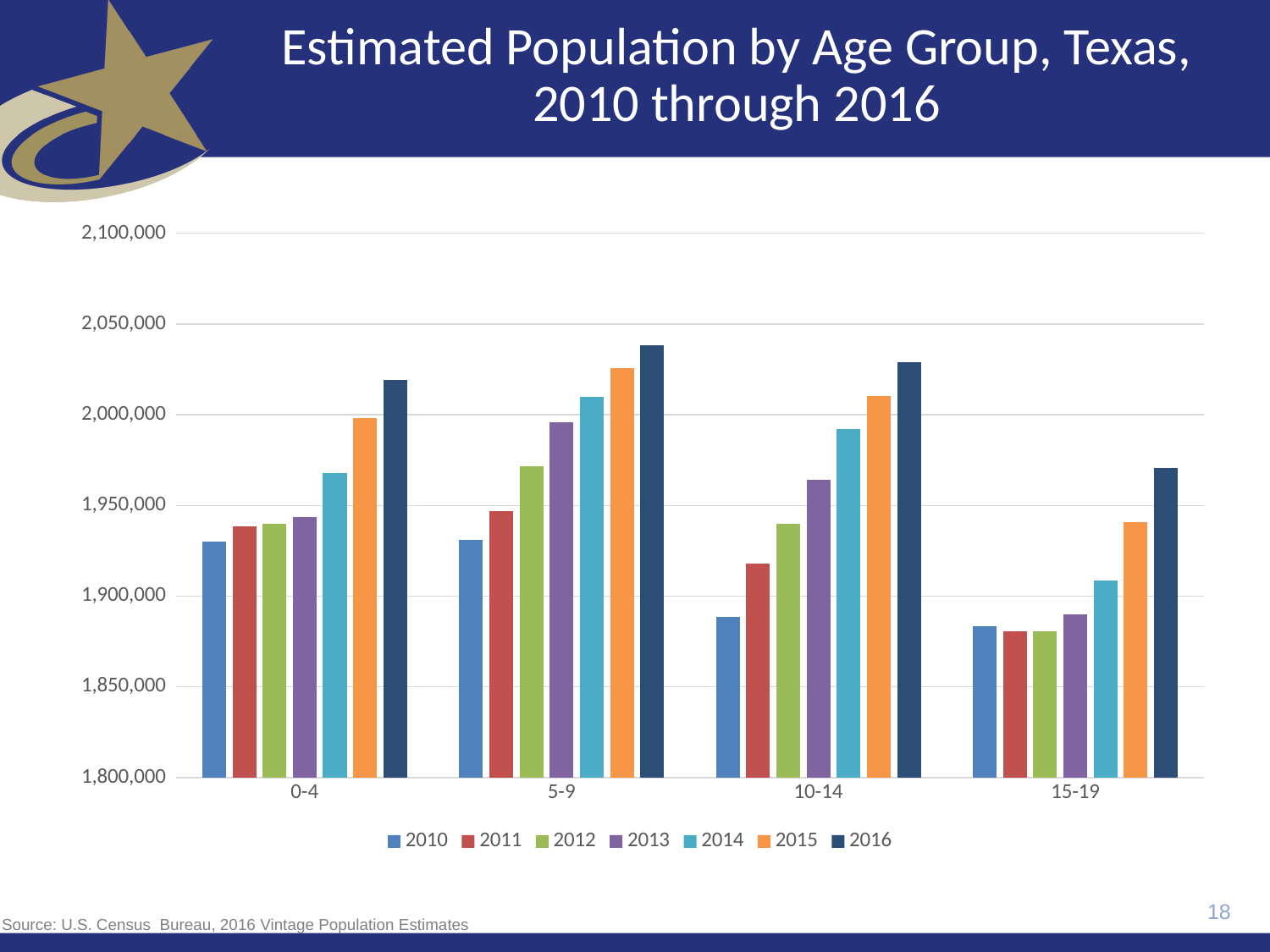
Which is larger: the 2015 value for 10-14 or the 2015 value for 15-19? 10-14 How many series (years) does the legend list? 7 Which age group has the lowest 2016 value? 15-19 What is the source cited for the chart data? U.S. Census Bureau, 2016 Vintage Population Estimates For the 5-9 age group, do the values rise or fall from 2010 to 2016? rise What kind of chart is shown on the slide? Bar chart How many age groups are shown on the x axis? 4 Within the 0-4 age group, which year has the highest value? 2016 Is the 2016 value for the 15-19 age group greater or less than 2,000,000? less Is the 2015 value for the 5-9 age group greater or less than 2,000,000? greater Is the 2010 value for the 10-14 age group greater or less than 1,900,000? less